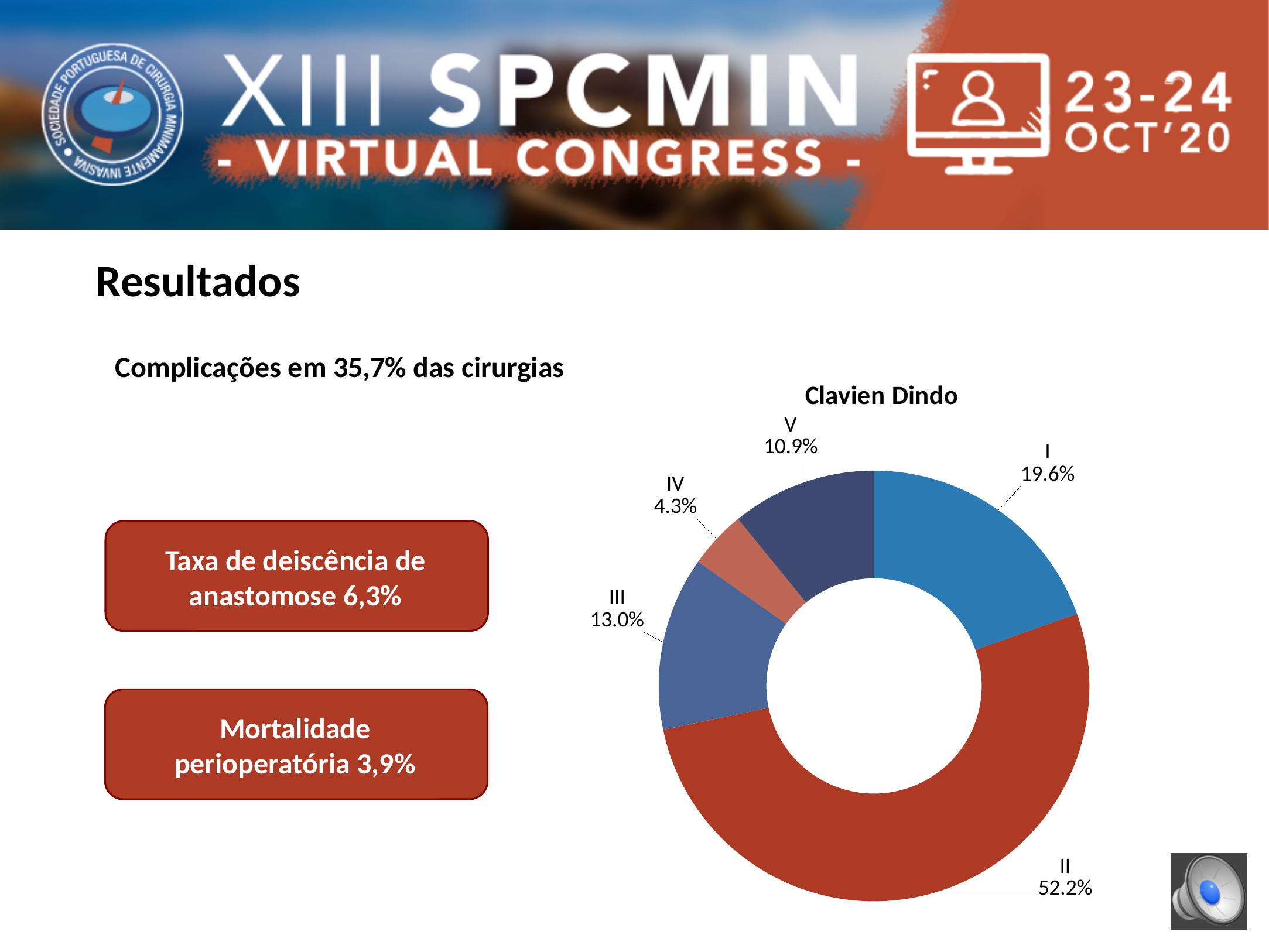
How many categories does the Clavien Dindo chart show? 5 What is the share for category IV? 4.3% Which has a larger share, category III or category V? III What is the share for category V? 10.9% What is the share for category I? 19.6% What is the share for category III? 13.0% Which category has the largest share? II What is the difference between the shares of category II and category I? 32.6% Which category has the smallest share? IV What is the title of the chart? Clavien Dindo What kind of chart is shown on the slide? Doughnut (pie) chart What is the share for category II? 52.2%